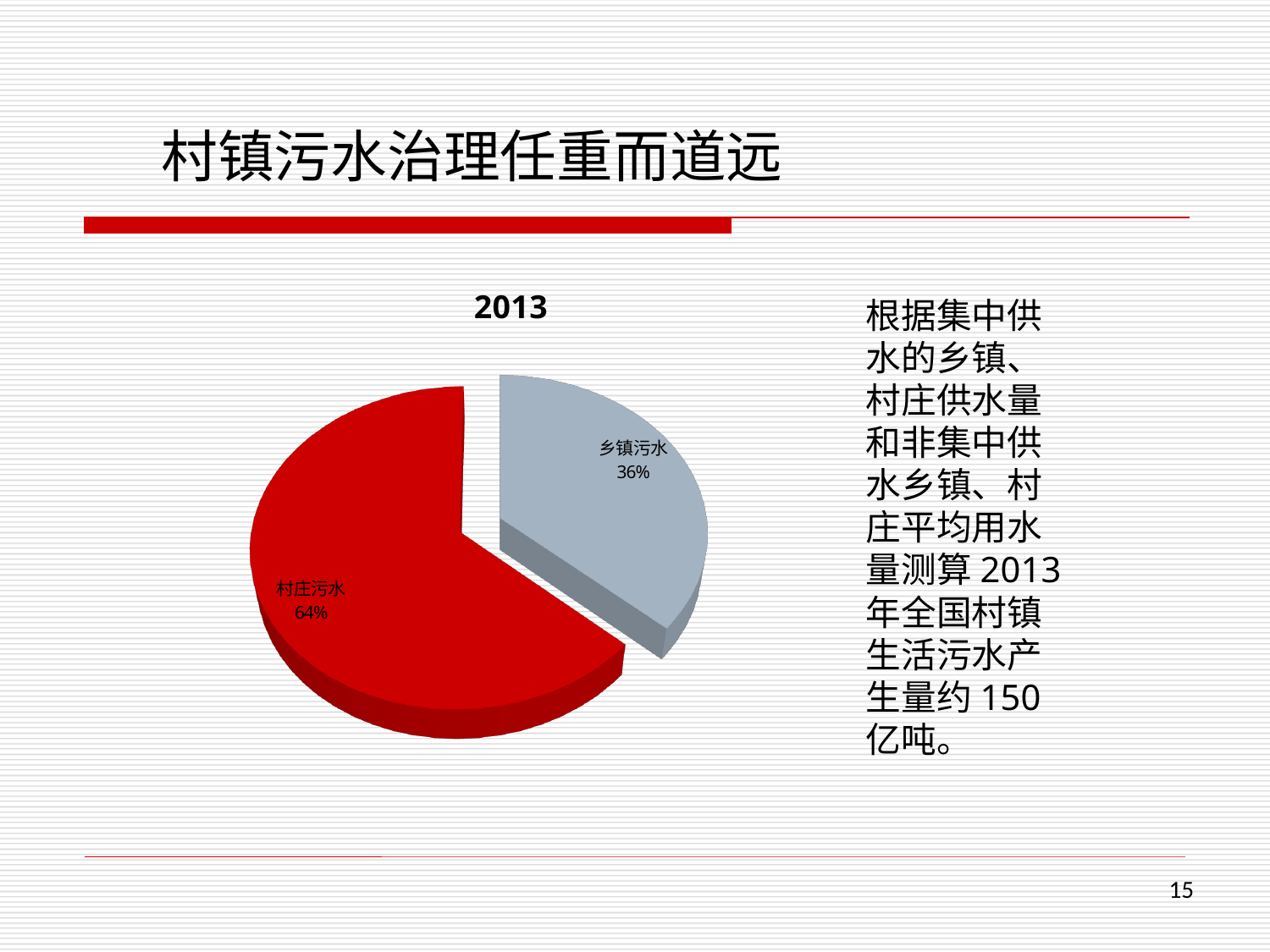
Is the share for 乡镇污水 greater or less than 50%? less Which slice of the pie is the smallest? 乡镇污水 What is the title of the chart? 2013 Which is larger, the 村庄污水 slice or the 乡镇污水 slice? 村庄污水 What share of the pie does 乡镇污水 represent? 36% What kind of chart is shown on the slide? pie chart What colour is the 村庄污水 slice? red Which slice of the pie is the largest? 村庄污水 How many slices does the pie chart have? 2 What share of the pie does 村庄污水 represent? 64% What is the difference in percentage points between the 村庄污水 and 乡镇污水 slices? 28